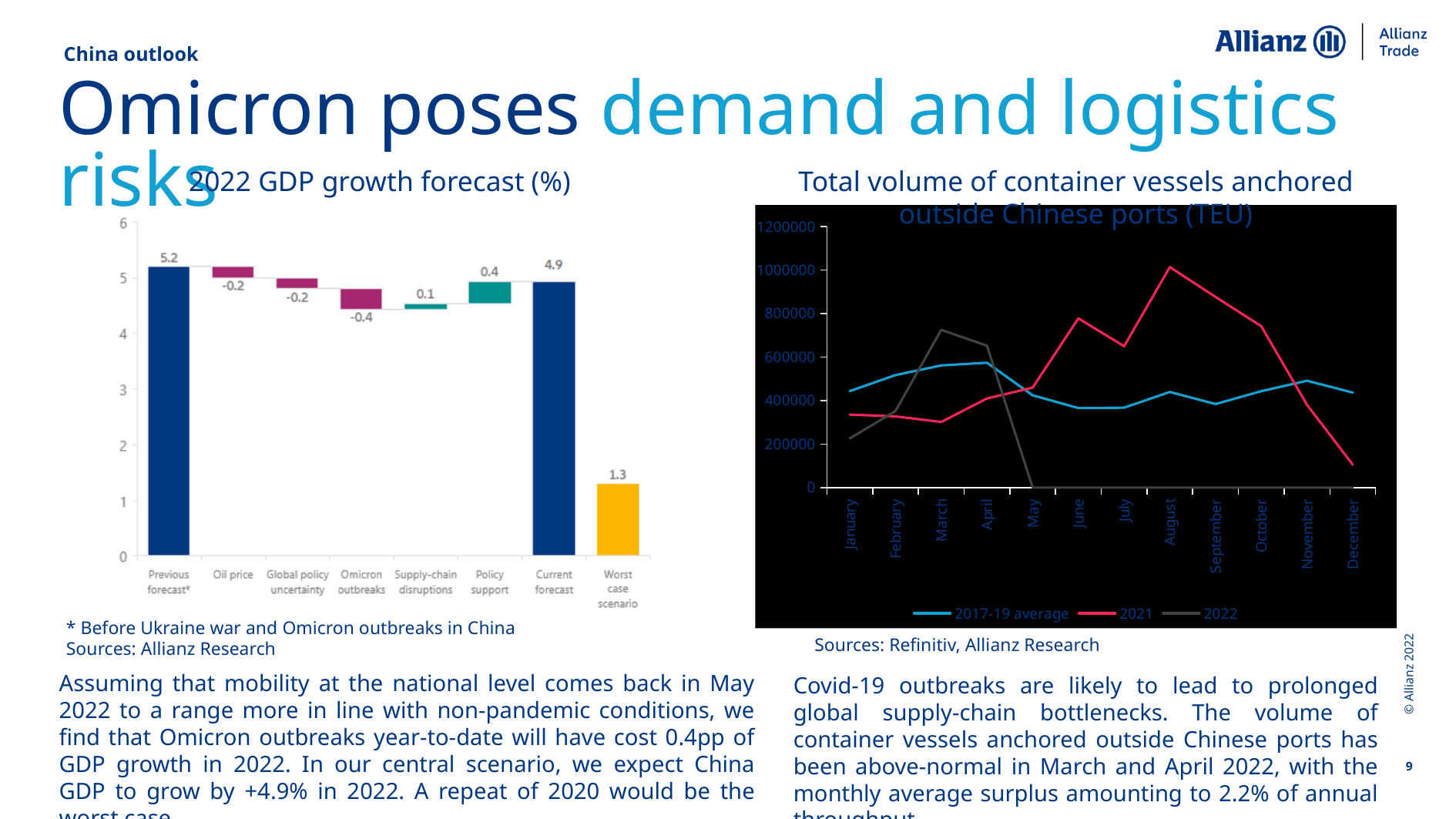
In the 2022 GDP growth forecast chart, what is the difference between the Previous forecast and the Current forecast? 0.3 In the 2022 GDP growth forecast chart, what is the value shown for Omicron outbreaks? -0.4 In the 2022 GDP growth forecast chart, what is the value for the Worst case scenario? 1.3 In the 2022 GDP growth forecast chart, what is the Current forecast value? 4.9 In the container vessels chart, in which month is the 2021 series at its lowest value? December In the container vessels chart, is the 2021 value for August greater or less than 800000? greater In the 2022 GDP growth forecast chart, which is larger: the value for Policy support or for Supply-chain disruptions? Policy support How many categories are shown on the x axis of the 2022 GDP growth forecast chart? 8 What kind of chart is the chart of total volume of container vessels anchored outside Chinese ports? Line chart In the container vessels chart, in which month does the 2021 series reach its highest value? August In the 2022 GDP growth forecast chart, what is the value for the Previous forecast? 5.2 How many series does the legend list in the chart of container vessels anchored outside Chinese ports? 3